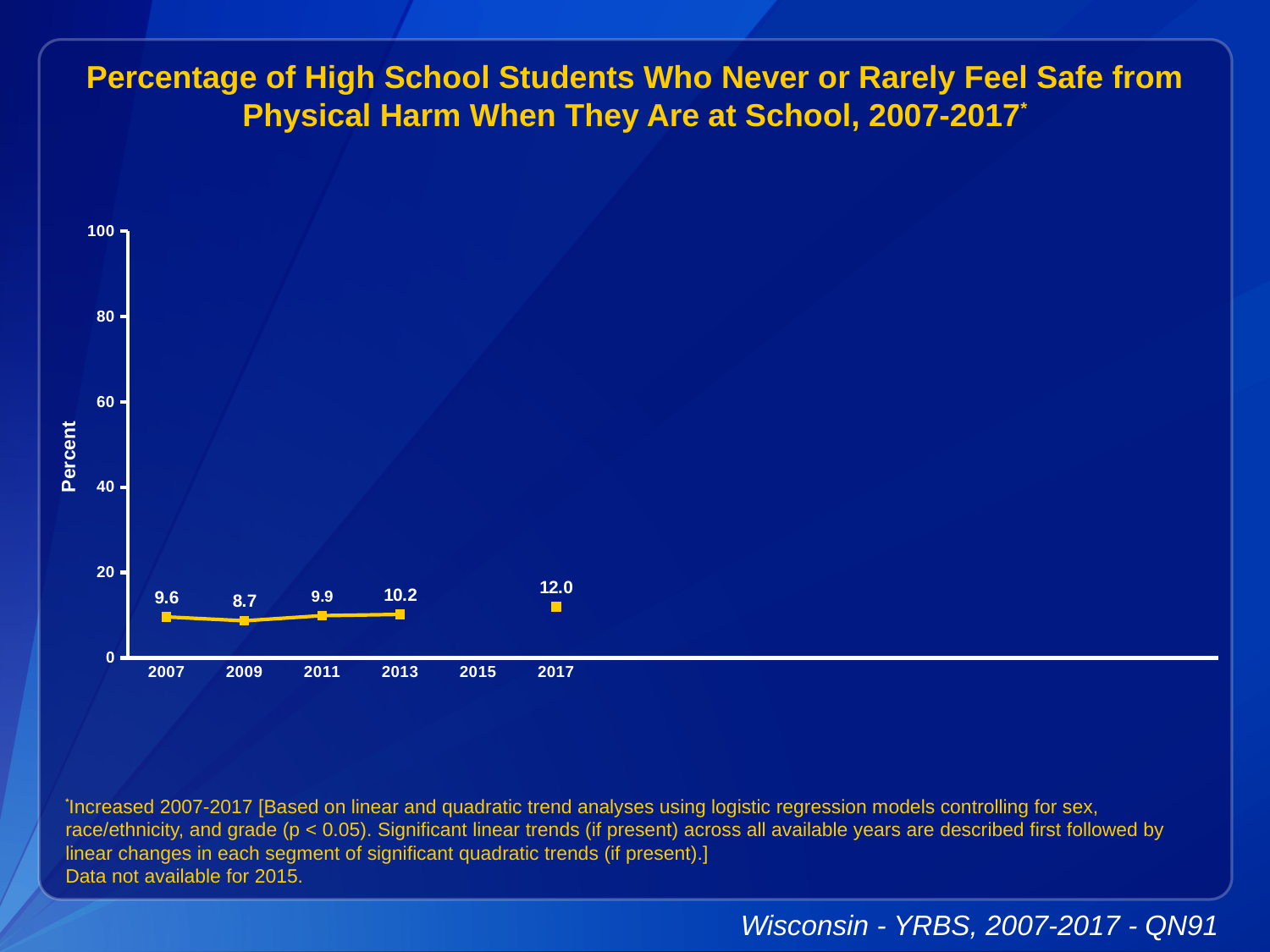
What is the value for 2013? 10.2 How many data points are plotted on the chart? 5 Which is larger, the value for 2011 or the value for 2013? 2013 What is the value for 2009? 8.7 What is the value for 2007? 9.6 Is the value for 2017 greater or less than 20? less Which year has the lowest value? 2009 What kind of chart is shown on the slide? line chart Which year has the highest value? 2017 What is the difference between the values for 2017 and 2007? 2.4 What is the label on the y axis? Percent What is the value for 2017? 12.0